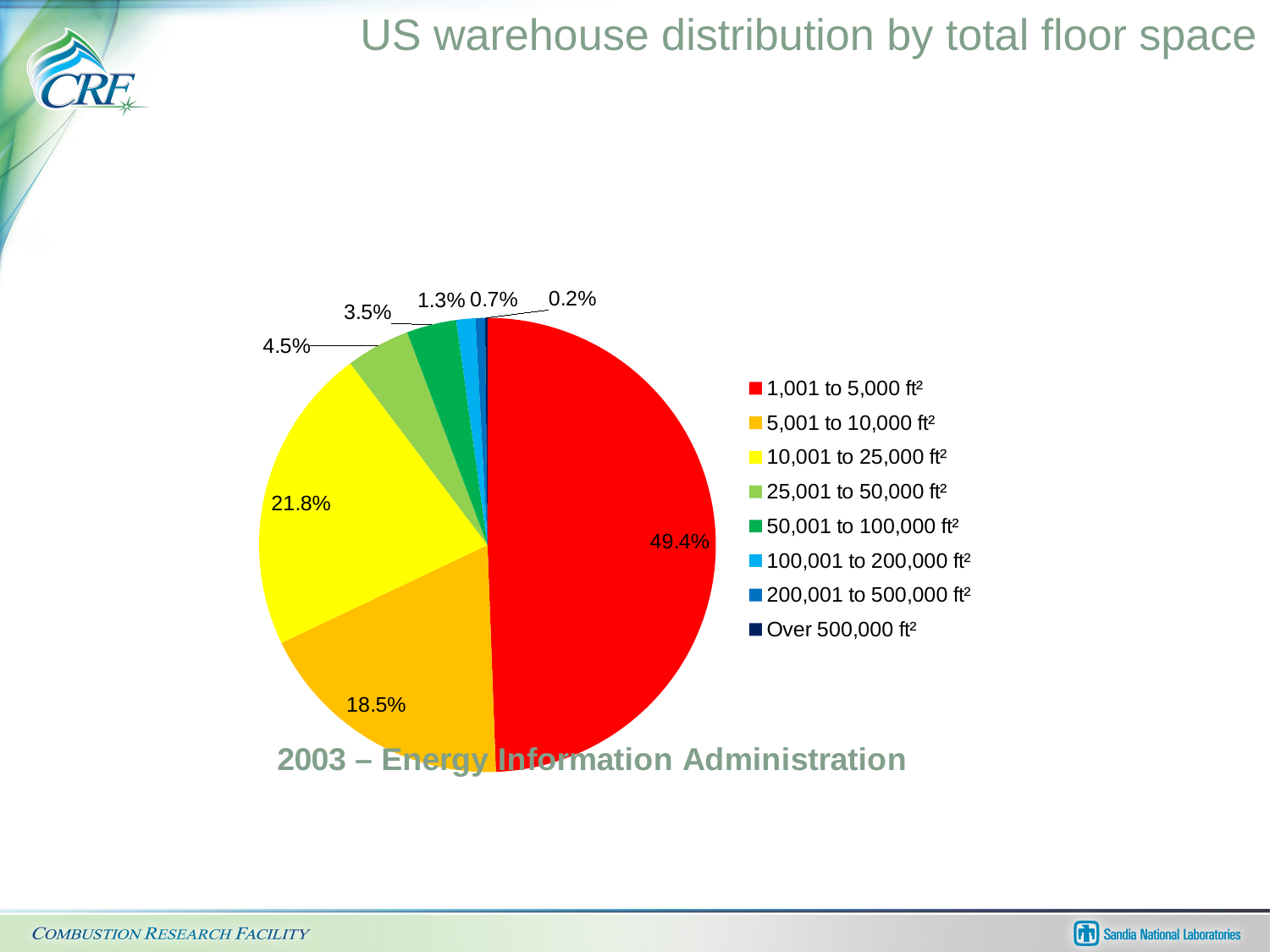
What share of US warehouses have 10,001 to 25,000 ft² of floor space? 21.8% What is the title of the chart on the slide? 2003 – Energy Information Administration What share of US warehouses have over 500,000 ft² of floor space? 0.2% Which category has a larger share: 25,001 to 50,000 ft² or 50,001 to 100,000 ft²? 25,001 to 50,000 ft² Which floor space category has the smallest share of US warehouses? Over 500,000 ft² What colour is the slice for 10,001 to 25,000 ft²? Yellow What share of US warehouses have 5,001 to 10,000 ft² of floor space? 18.5% What share of US warehouses have 1,001 to 5,000 ft² of floor space? 49.4% Which floor space category has the largest share of US warehouses? 1,001 to 5,000 ft² What is the difference in share between the 10,001 to 25,000 ft² and 5,001 to 10,000 ft² categories? 3.3% How many floor space categories does the pie chart show? 8 What kind of chart is shown on the slide? Pie chart